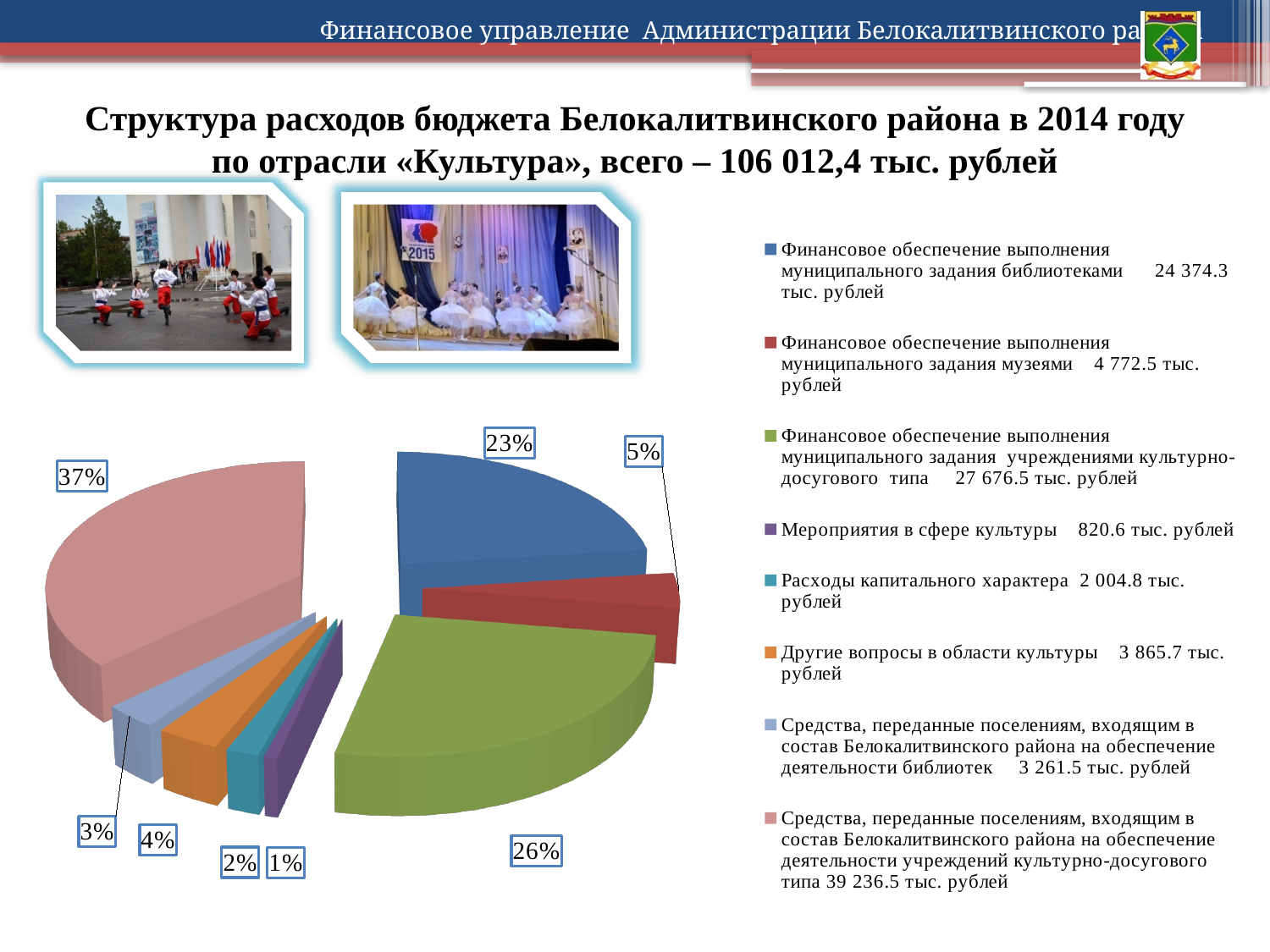
According to the legend, what is the amount for 'Финансовое обеспечение выполнения муниципального задания музеями'? 4 772.5 тыс. рублей What share of the pie chart is labelled for the pink slice (funds transferred to settlements for cultural-leisure institutions)? 37% How many entries does the legend of the pie chart list? 8 Which is larger: the share for libraries (blue slice) or the share for cultural-leisure institutions (green slice)? cultural-leisure institutions (green slice), 26% What is the difference in percentage points between the largest slice (37%) and the blue slice (23%)? 14 percentage points What kind of chart is shown on the slide? pie chart Which category has the largest share of the pie chart? Средства, переданные поселениям, входящим в состав Белокалитвинского района на обеспечение деятельности учреждений культурно-досугового типа Which category has the smallest share of the pie chart? Мероприятия в сфере культуры What percentage is shown for the blue slice (financial support of the municipal task by libraries)? 23% According to the legend, what is the amount for 'Расходы капитального характера'? 2 004.8 тыс. рублей What percentage is shown for the green slice (financial support of the municipal task by cultural-leisure institutions)? 26% How many slices does the pie chart have? 8